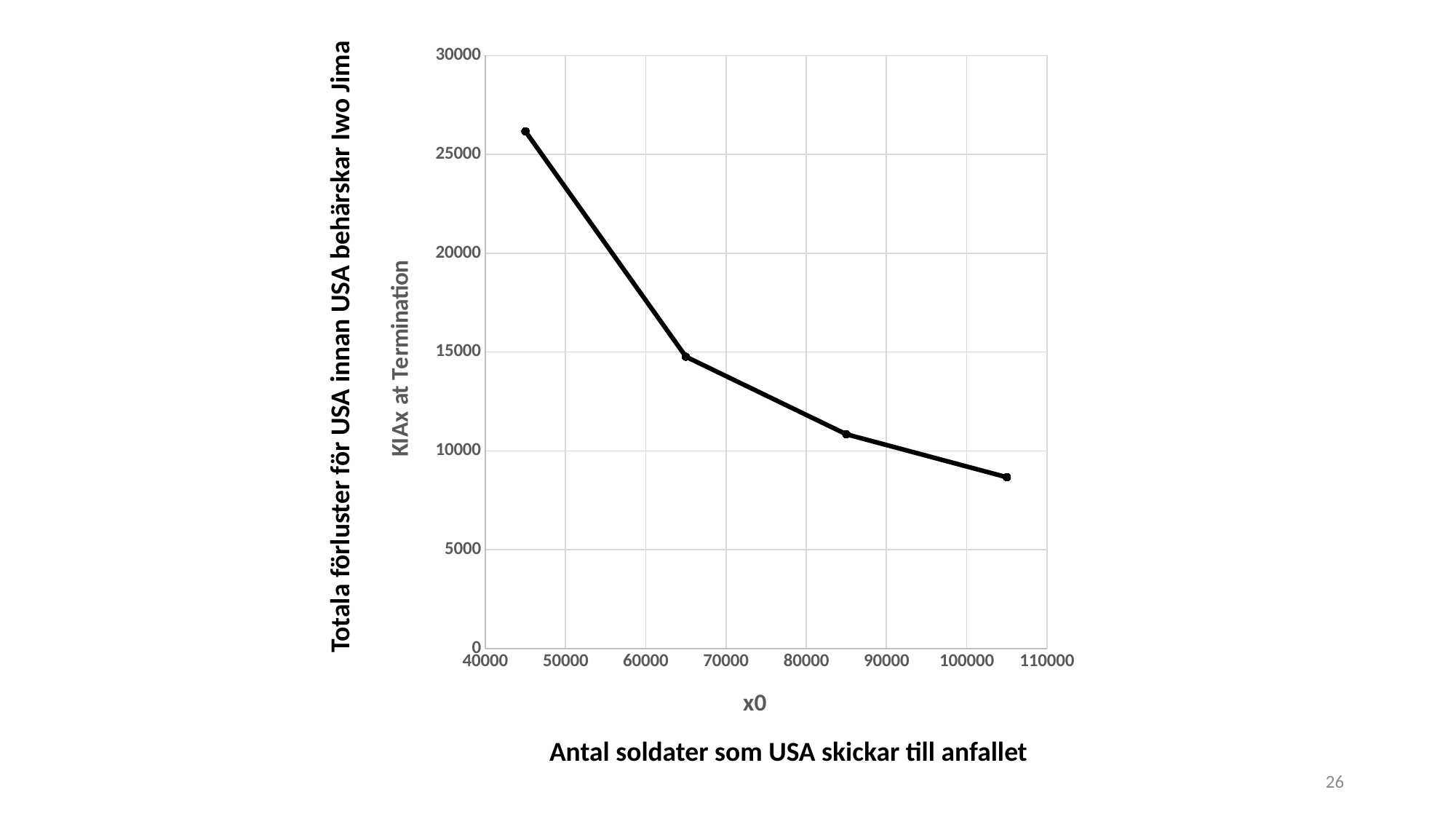
What kind of chart is shown on the slide? line chart Is the value of the second data point from the left greater or less than 20000? less What is the label of the x axis? x0 Is the value of the third data point from the left greater or less than 10000? greater How many data points are plotted on the line? 4 Is the value of the rightmost data point greater or less than 10000? less Which data point has the highest value, the leftmost or the rightmost? the leftmost Which data point has the lowest value on the chart? the rightmost point Do the values rise or fall as x0 increases along the x axis? fall What is the label of the y axis? KIAx at Termination